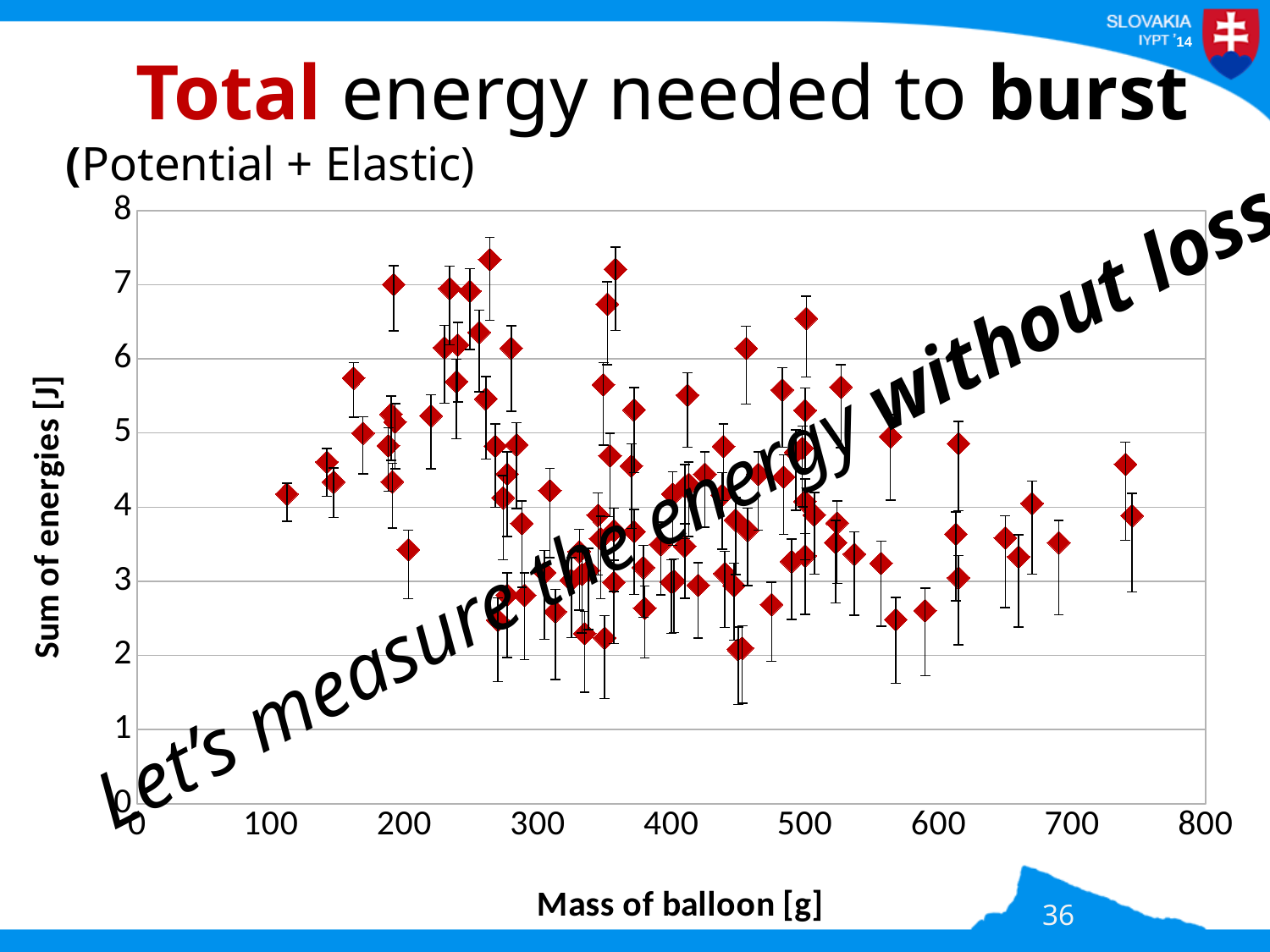
Is the sum of energies for the heaviest balloon (around 745 g) greater or less than 5? less Are any plotted points below 1 J on the chart? no Are any plotted points above 8 J on the chart? no What kind of chart is shown on the slide? scatter chart What is the label of the vertical axis of the chart? Sum of energies [J] What is the label of the horizontal axis of the chart? Mass of balloon [g]